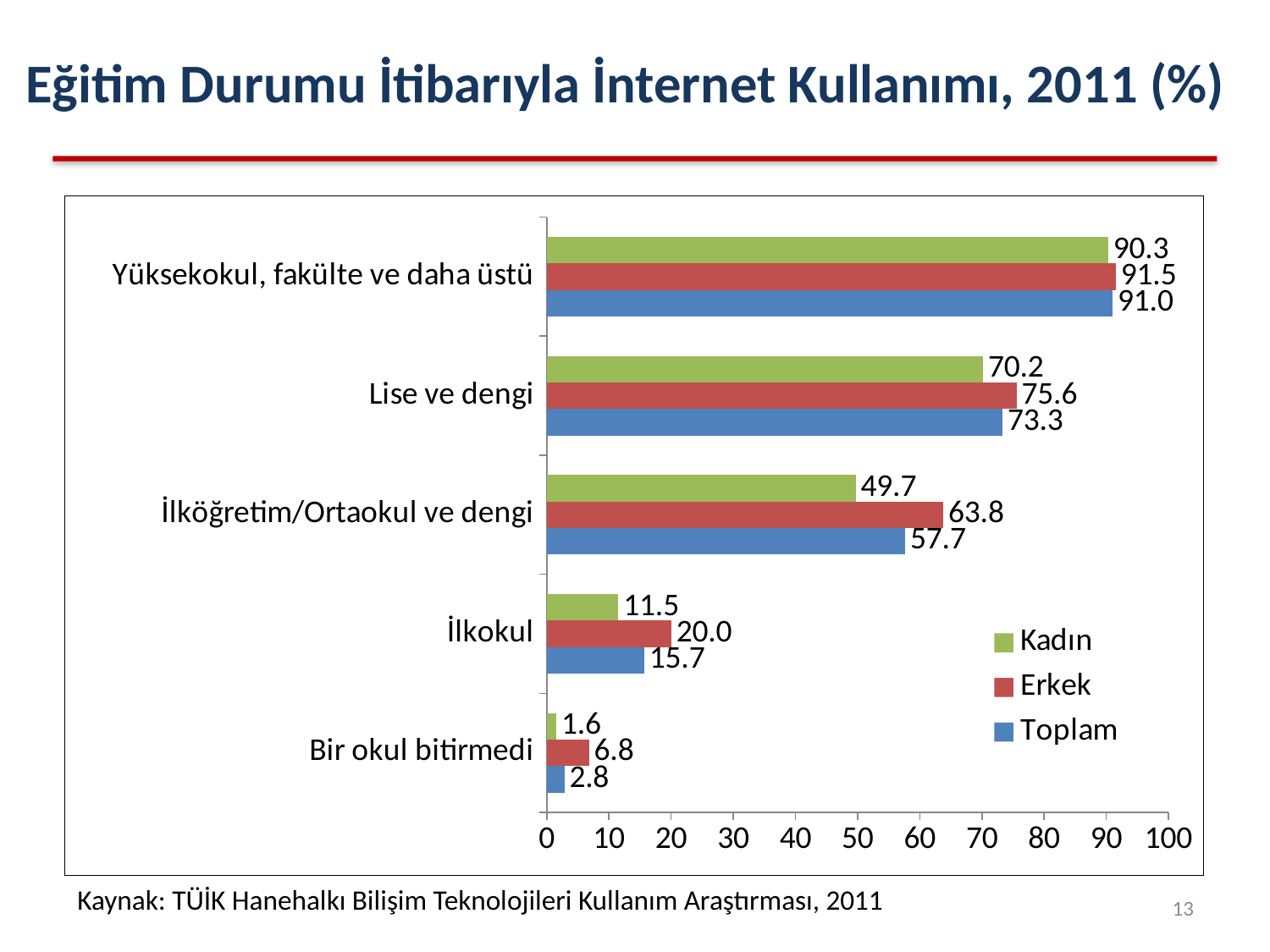
What is the difference between the Toplam values for Yüksekokul, fakülte ve daha üstü and Lise ve dengi? 17.7 How many education categories are shown on the chart? 5 Which colour represents the Toplam series in the legend? Blue What kind of chart is shown on the slide? Bar chart What is the Kadın value for Lise ve dengi? 70.2 Which education category has the lowest Kadın value? Bir okul bitirmedi What is the Toplam value for Bir okul bitirmedi? 2.8 What is the Erkek value for İlköğretim/Ortaokul ve dengi? 63.8 Which is larger for İlkokul: the Erkek value or the Kadın value? Erkek What is the difference between the Erkek and Kadın values for İlköğretim/Ortaokul ve dengi? 14.1 How many series does the legend list? 3 Which education category has the highest Toplam value? Yüksekokul, fakülte ve daha üstü